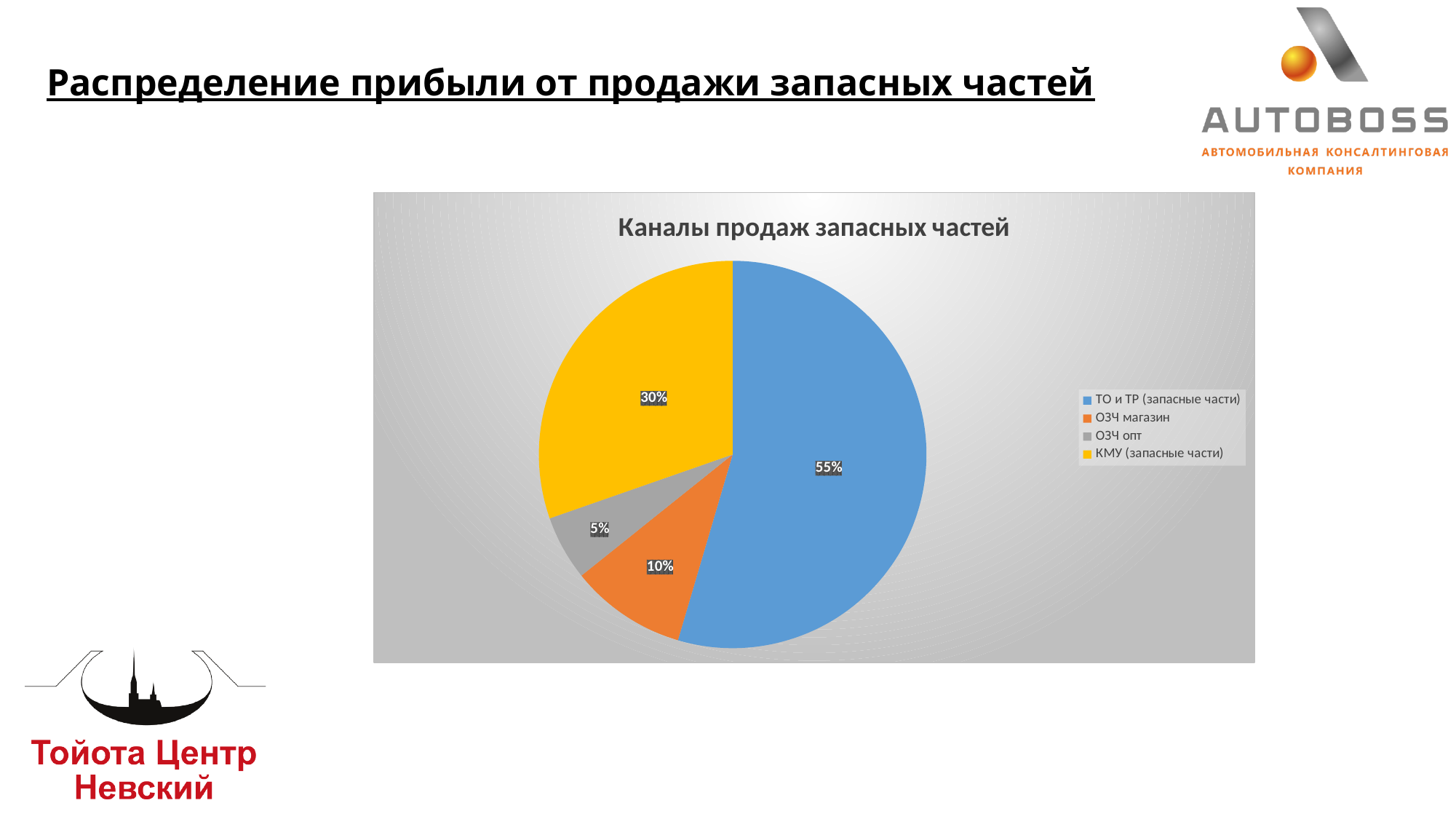
What kind of chart is shown on the slide? Pie chart What colour is the slice for КМУ (запасные части)? Yellow What share of the pie does ОЗЧ опт have? 5% Which is larger, the share for ОЗЧ магазин or the share for ОЗЧ опт? ОЗЧ магазин What is the difference in percentage points between ТО и ТР (запасные части) and КМУ (запасные части)? 25% How many categories are shown in the pie chart? 4 Which category has the smallest slice of the pie? ОЗЧ опт Which category has the largest slice of the pie? ТО и ТР (запасные части) What share of the pie does ОЗЧ магазин have? 10% What share of the pie does ТО и ТР (запасные части) have? 55% What is the title of the chart? Каналы продаж запасных частей